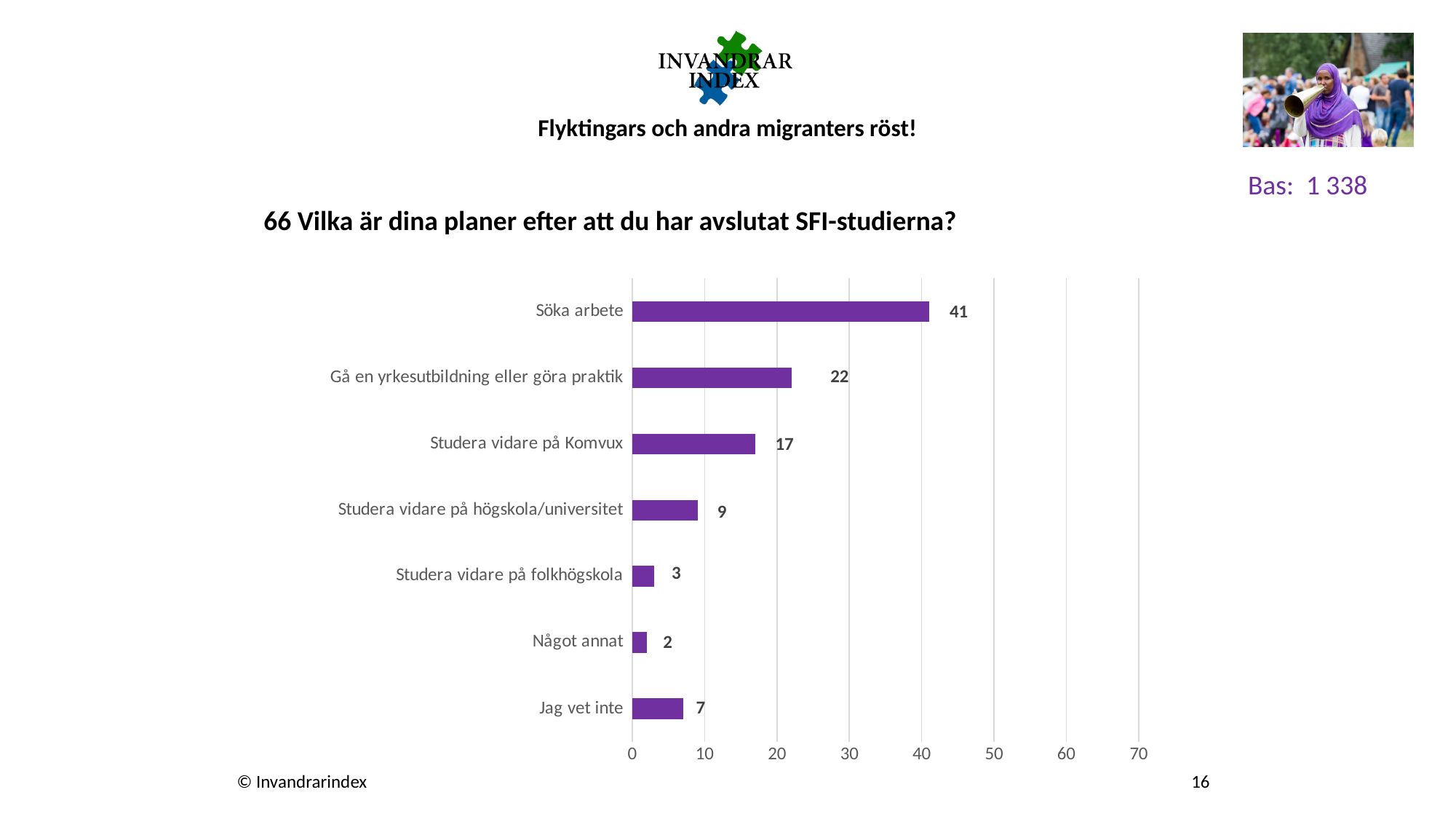
What is the title of the chart? 66 Vilka är dina planer efter att du har avslutat SFI-studierna? What is the value for "Jag vet inte"? 7 What is the value for "Gå en yrkesutbildning eller göra praktik"? 22 What is the value for "Söka arbete"? 41 What is the value for "Studera vidare på Komvux"? 17 How many categories are shown in the chart? 7 Is the value for "Studera vidare på Komvux" greater or less than 20? less Which category has the highest value? Söka arbete Which is larger, the value for "Studera vidare på högskola/universitet" or the value for "Jag vet inte"? Studera vidare på högskola/universitet What is the difference between the values for "Söka arbete" and "Gå en yrkesutbildning eller göra praktik"? 19 Which category has the lowest value? Något annat What kind of chart is shown on the slide? bar chart